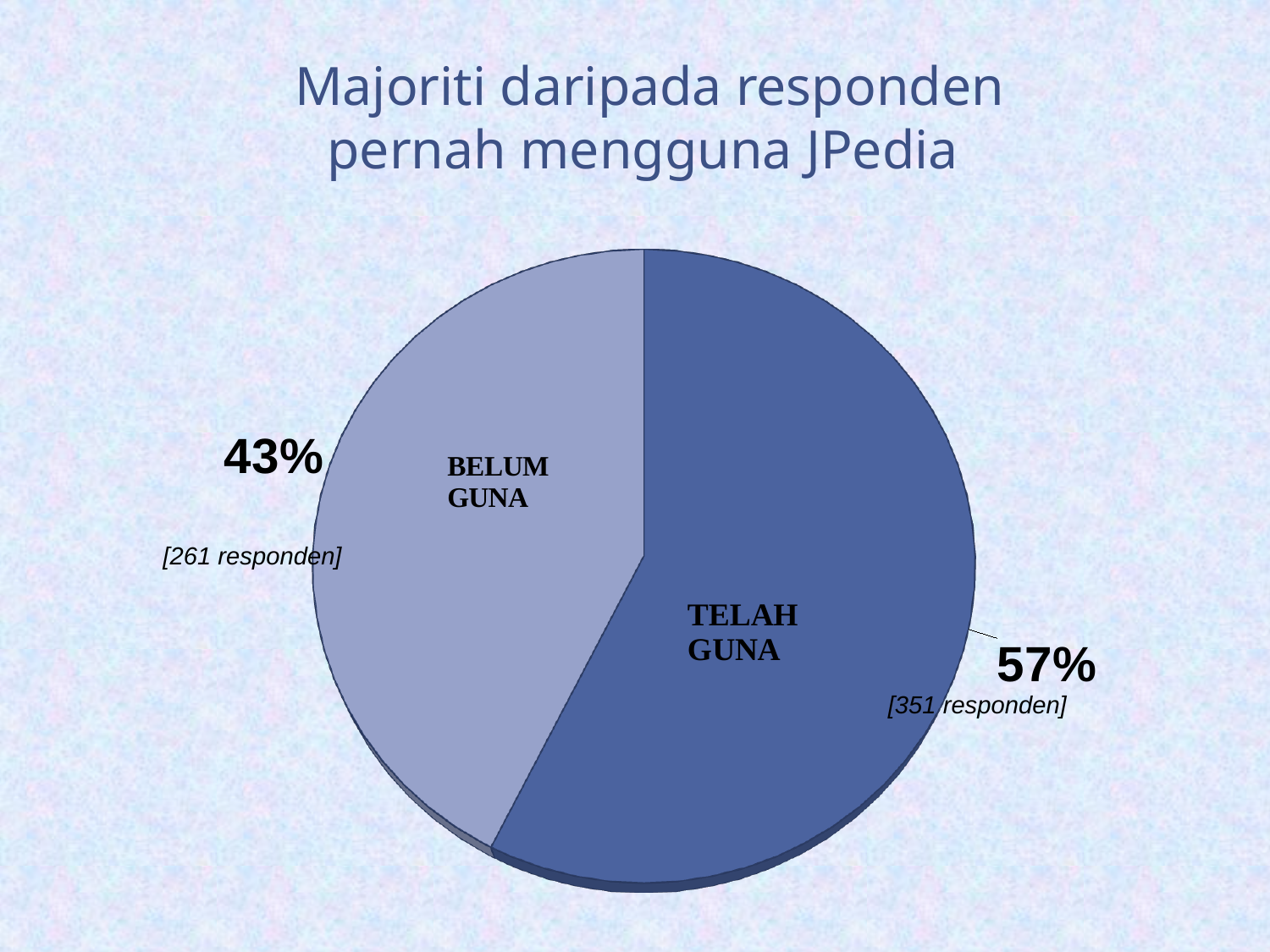
What is the title of the slide containing the chart? Majoriti daripada responden pernah mengguna JPedia Which slice of the pie is the smallest? BELUM GUNA What share of the pie does the TELAH GUNA slice represent? 57% What kind of chart is shown on the slide? Pie chart How many respondents are in the BELUM GUNA slice? 261 responden What is the difference in number of respondents between TELAH GUNA and BELUM GUNA? 90 Which slice of the pie is the largest? TELAH GUNA What is the difference in percentage points between the TELAH GUNA and BELUM GUNA slices? 14% How many respondents are in the TELAH GUNA slice? 351 responden Which is larger, the TELAH GUNA slice or the BELUM GUNA slice? TELAH GUNA What share of the pie does the BELUM GUNA slice represent? 43% How many slices does the pie chart have? 2